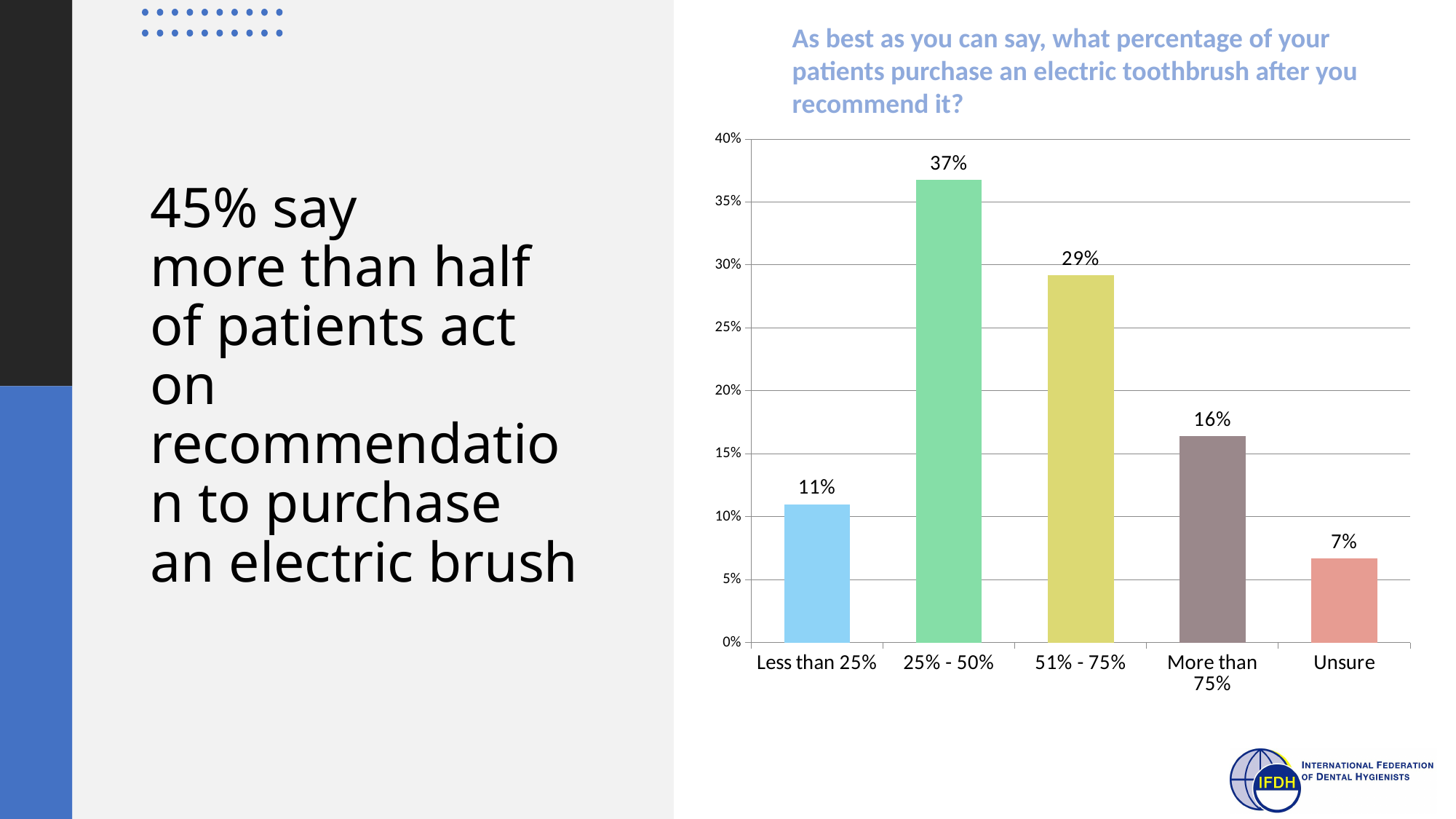
How many categories are shown on the x axis? 5 Which category has the lowest value? Unsure What is the value for the "Less than 25%" category? 11% What is the difference between the values for "25% - 50%" and "51% - 75%"? 8% What is the title of the chart? As best as you can say, what percentage of your patients purchase an electric toothbrush after you recommend it? What is the value for the "25% - 50%" category? 37% What kind of chart is shown on the slide? Bar chart Which category has the highest value? 25% - 50% What is the value for the "Unsure" category? 7% Which is larger, the value for "51% - 75%" or the value for "More than 75%"? 51% - 75% What is the value for the "More than 75%" category? 16% Is the value for "51% - 75%" greater or less than 25%? greater